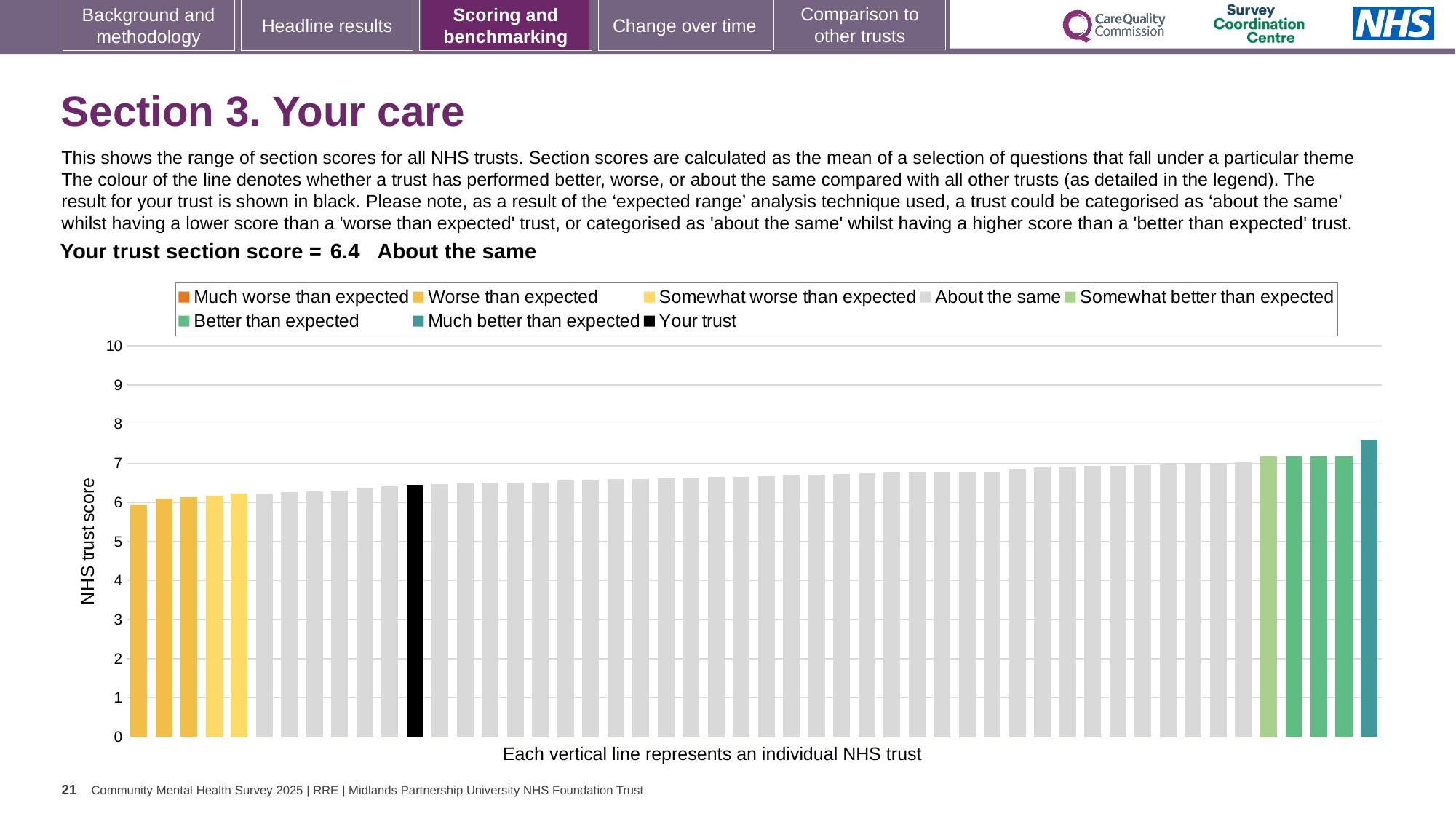
Is the value of the shortest bar greater or less than 5? greater Do the bar values rise or fall from left to right along the x axis? Rise What kind of chart is shown on the slide? Bar chart Which legend category does the tallest bar belong to? Much better than expected Is the value of the tallest bar greater or less than 7? greater Which is taller, the leftmost bar or the rightmost bar? The rightmost bar What is the label on the vertical axis of the chart? NHS trust score Is the value of the black bar (your trust) greater or less than 5? greater What is the section score for your trust shown on the slide? 6.4 Which performance category is your trust placed in for Section 3? About the same How many entries does the chart legend list? 8